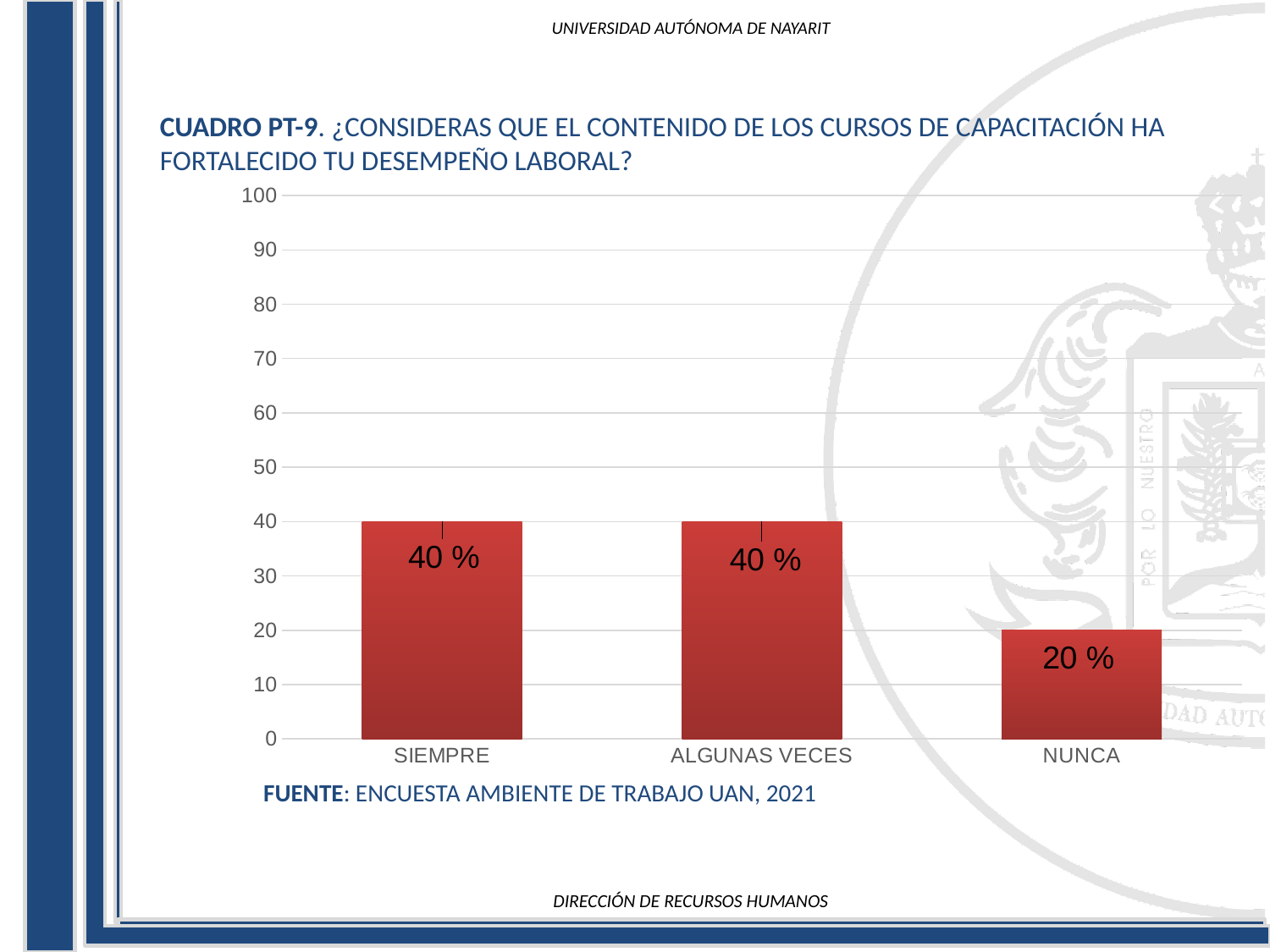
Which category has the lowest value? NUNCA What source is cited below the chart? ENCUESTA AMBIENTE DE TRABAJO UAN, 2021 What is the value for ALGUNAS VECES? 40 % Which is larger, the value for ALGUNAS VECES or the value for NUNCA? ALGUNAS VECES What kind of chart is shown on the slide? bar chart Is the value for NUNCA greater or less than 30? less What is the value for SIEMPRE? 40 % Is the value for SIEMPRE greater or less than 50? less How many categories are shown on the x axis? 3 What is the difference between the values for SIEMPRE and NUNCA? 20 % What is the value for NUNCA? 20 % What is the maximum value shown on the y axis? 100